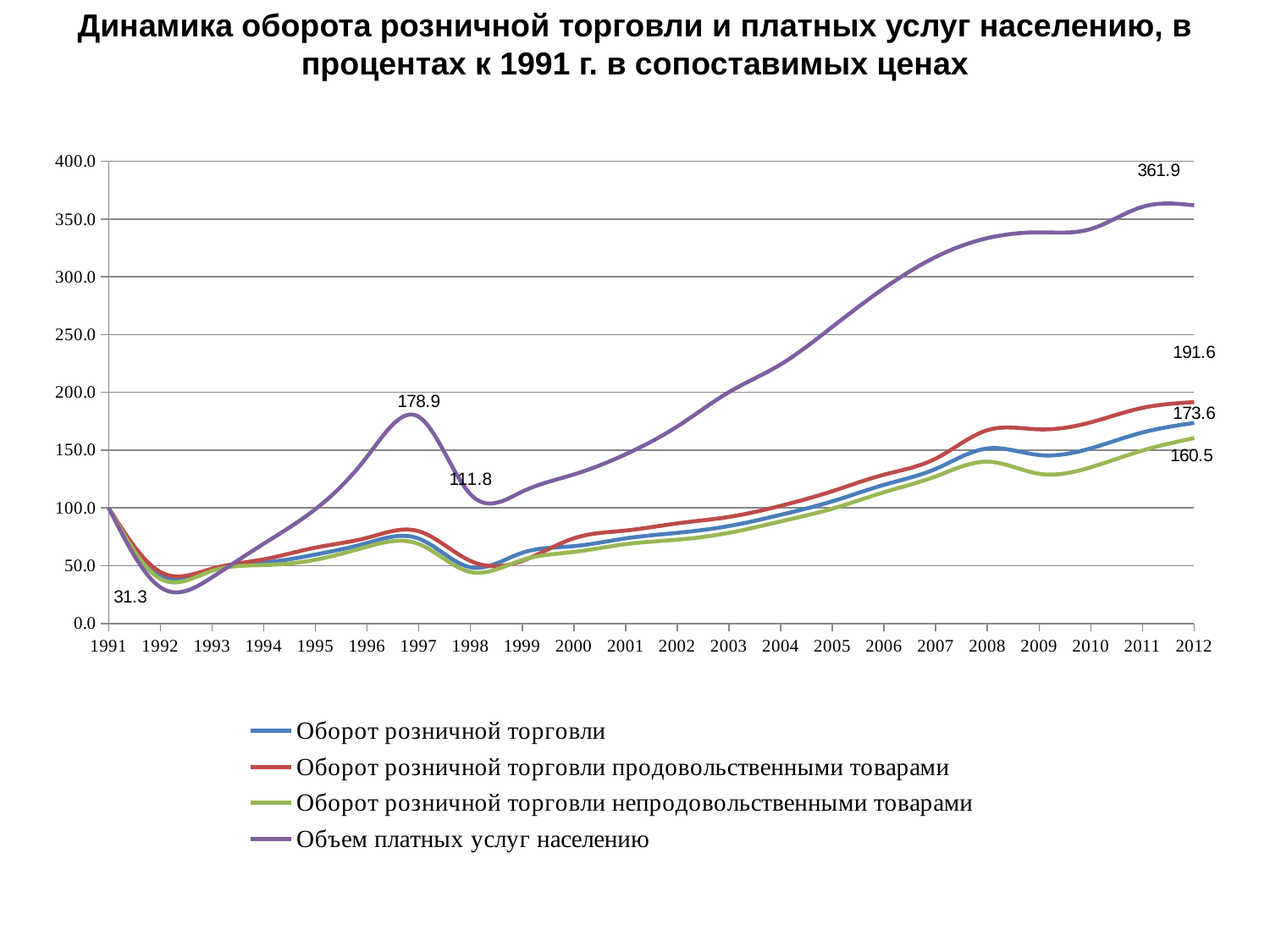
What is the labelled peak value of Объем платных услуг населению in 1997? 178.9 How many years are shown along the x axis? 22 What is the difference between the 2012 values of Оборот розничной торговли продовольственными товарами and Оборот розничной торговли непродовольственными товарами? 31.1 What is the value of Оборот розничной торговли непродовольственными товарами in 2012? 160.5 What type of chart is shown on the slide? line chart Which series has the highest value in 2012? Объем платных услуг населению What is the labelled minimum value of Объем платных услуг населению in 1992? 31.3 What is the value of Оборот розничной торговли in 2012? 173.6 Is the value of Оборот розничной торговли in 2005 greater or less than 150? less What is the value of Оборот розничной торговли продовольственными товарами in 2012? 191.6 What is the value of Объем платных услуг населению in 2012? 361.9 How many series does the legend list? 4